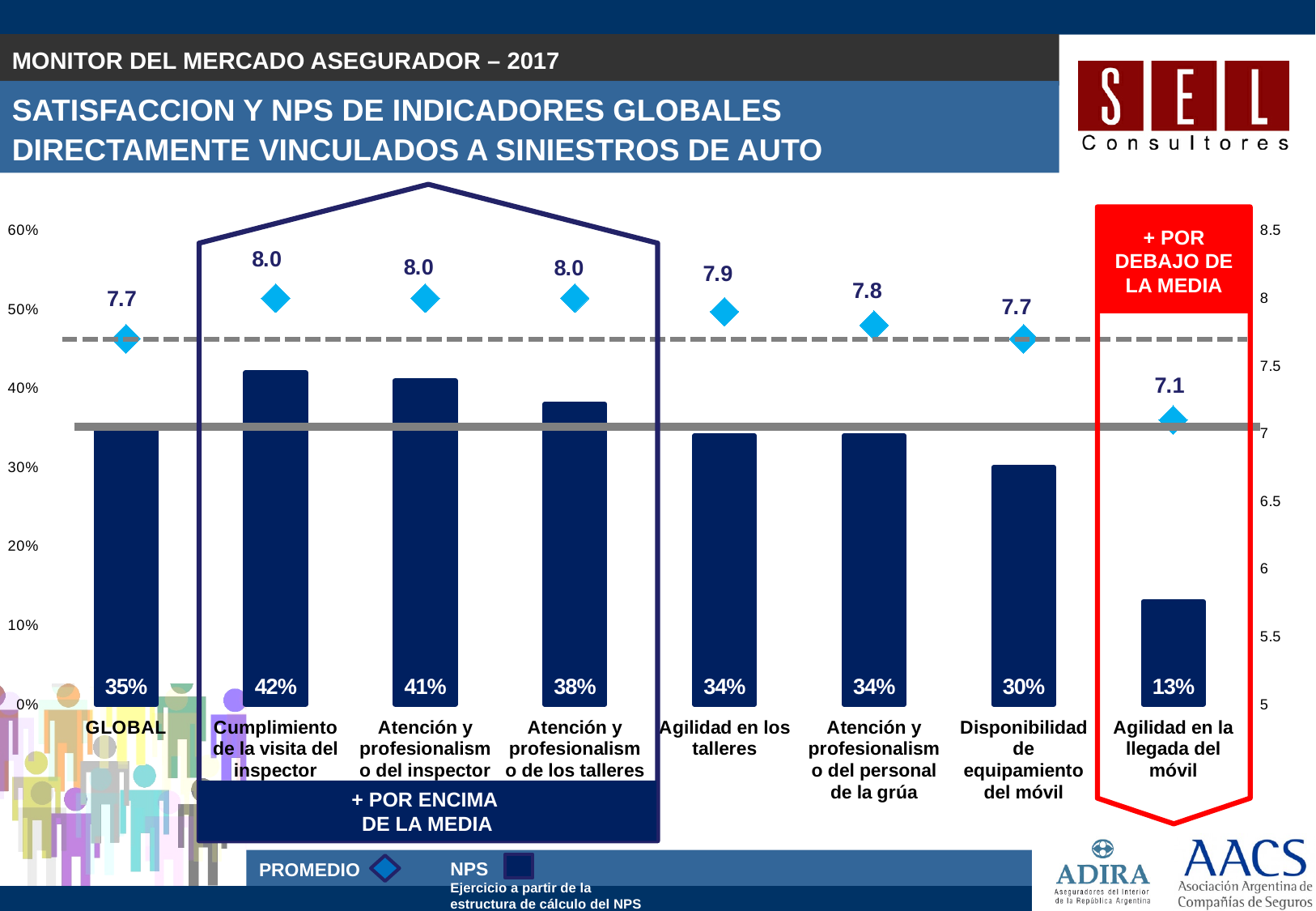
What is the PROMEDIO value for Agilidad en la llegada del móvil? 7.1 What is the NPS value for Disponibilidad de equipamiento del móvil? 30% How many categories are shown on the x axis? 8 Which has a higher NPS value, Atención y profesionalismo del inspector or Atención y profesionalismo de los talleres? Atención y profesionalismo del inspector What are the two series named in the legend? PROMEDIO and NPS What kind of chart is used to show the NPS values? Bar chart What is the PROMEDIO value for Agilidad en los talleres? 7.9 What is the NPS value for GLOBAL? 35% What is the difference between the NPS values for Cumplimiento de la visita del inspector and Agilidad en la llegada del móvil? 29% How many series does the legend list? 2 Which category has the lowest PROMEDIO value? Agilidad en la llegada del móvil Which category has the highest NPS value? Cumplimiento de la visita del inspector